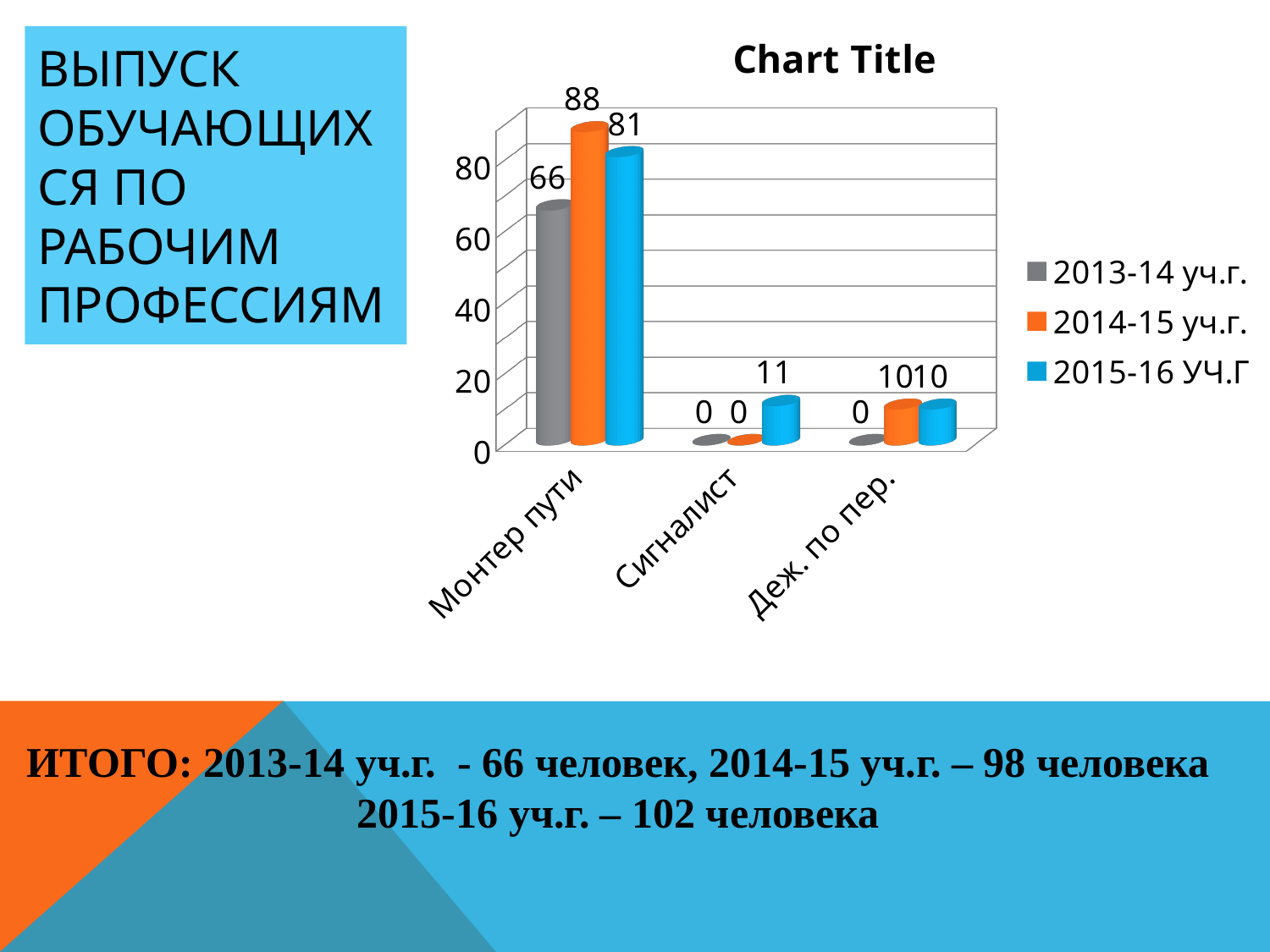
What is the value for Монтер пути in the 2014-15 уч.г. series? 88 What is the difference between the 2014-15 уч.г. and 2013-14 уч.г. values for Монтер пути? 22 What kind of chart is shown on the slide? Bar chart Which category has the highest value in the 2015-16 УЧ.Г series? Монтер пути What is the value for Монтер пути in the 2013-14 уч.г. series? 66 How many series does the legend list? 3 What is the value for Деж. по пер. in the 2014-15 уч.г. series? 10 What is the title shown above the chart? Chart Title What is the value for Сигналист in the 2015-16 УЧ.Г series? 11 How many categories are shown on the x axis? 3 Which series has the lowest value for Монтер пути? 2013-14 уч.г. Which is larger for Монтер пути: the 2014-15 уч.г. value or the 2015-16 УЧ.Г value? 2014-15 уч.г.